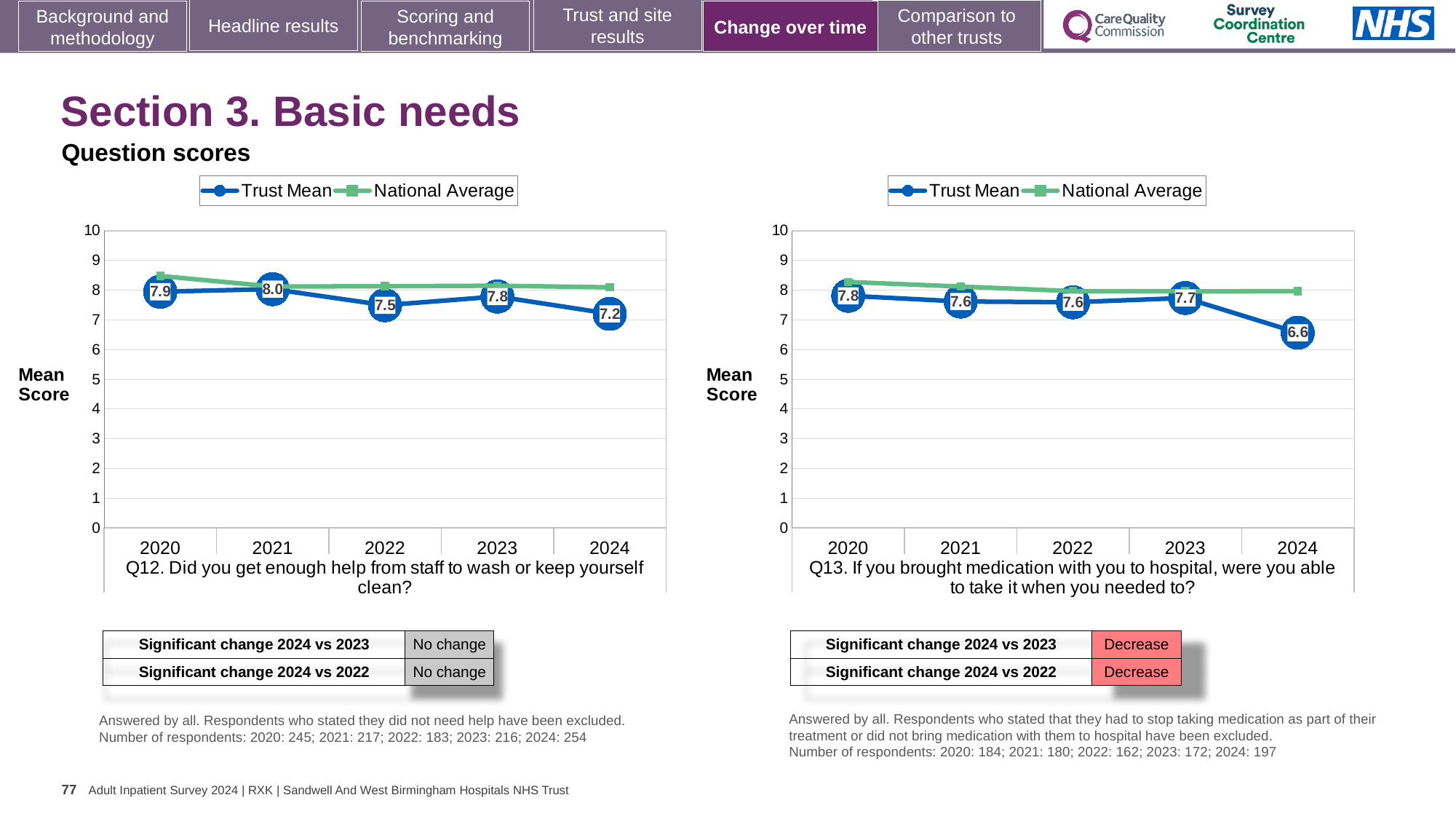
On the Q12 chart, what is the Trust Mean score for 2021? 8.0 On the Q12 chart, what is the Trust Mean score for 2024? 7.2 On the Q13 chart, is the National Average for 2024 greater or less than 7? greater On the Q13 chart, what is the Trust Mean score for 2024? 6.6 How many years are plotted on the Q12 chart? 5 On the Q12 chart, is the Trust Mean score for 2022 higher or lower than the Trust Mean score for 2023? lower How many series does the legend of the Q13 chart list? 2 On the Q12 chart, what is the difference between the Trust Mean scores for 2021 and 2024? 0.8 On the Q13 chart, what is the Trust Mean score for 2020? 7.8 On the Q13 chart, which year has the lowest Trust Mean score? 2024 On the Q12 chart, which year has the highest Trust Mean score? 2021 On the Q13 chart, what is the difference between the Trust Mean scores for 2023 and 2024? 1.1